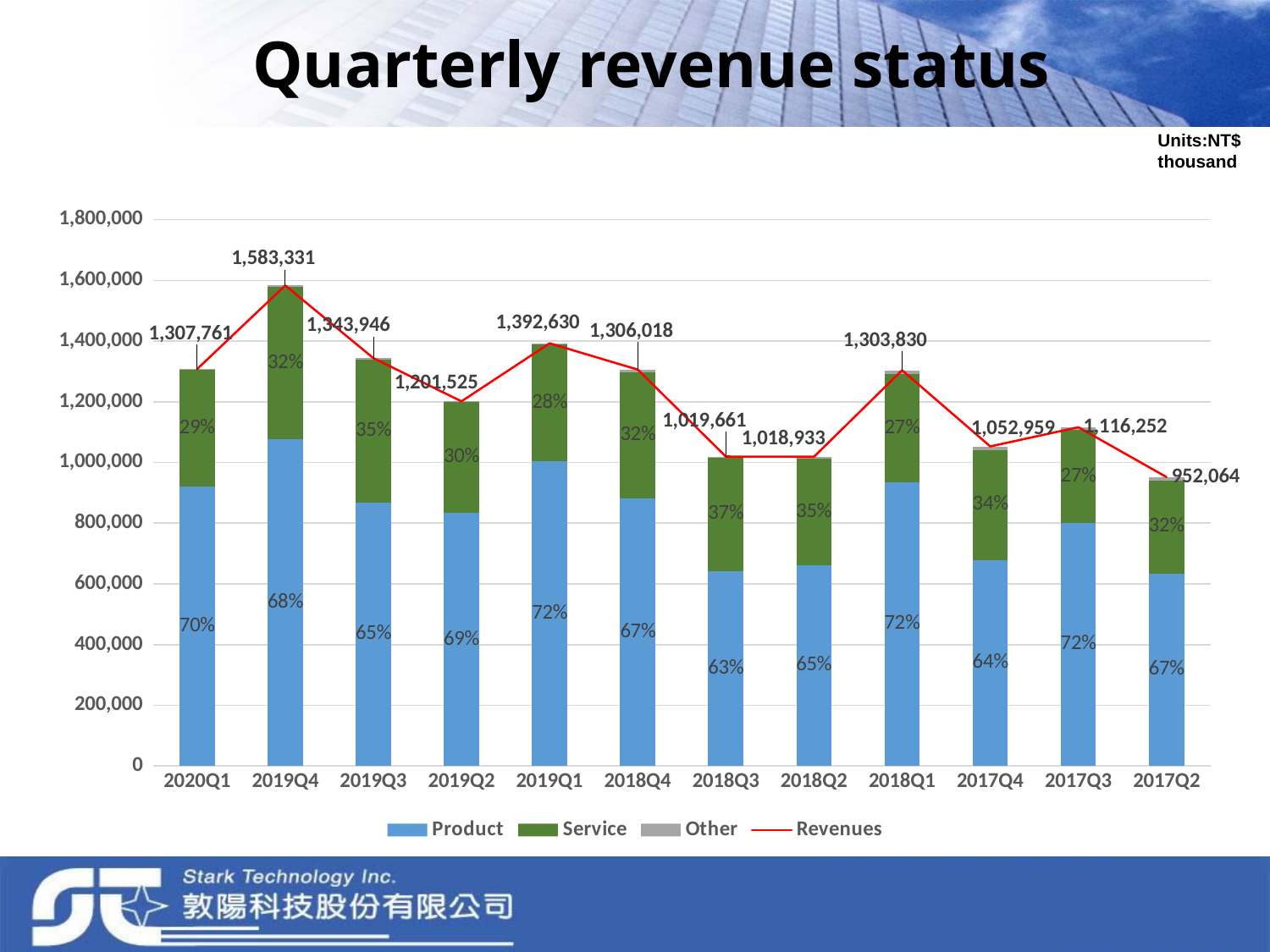
What percentage of revenue does Product account for in 2019Q1? 72% What percentage of revenue does Service account for in 2018Q3? 37% What unit is stated for the values in the chart? NT$ thousand How many quarters are shown on the x axis? 12 Which quarter has the highest revenue? 2019Q4 How many series does the legend list? 4 What is the revenue value shown for 2019Q4? 1,583,331 Which quarter has higher revenue, 2019Q1 or 2018Q4? 2019Q1 What is the difference in revenue between 2019Q4 and 2020Q1? 275,570 What is the revenue value shown for 2017Q2? 952,064 Is the Product value for 2019Q4 greater or less than 1,000,000? greater Which quarter has the lowest revenue? 2017Q2